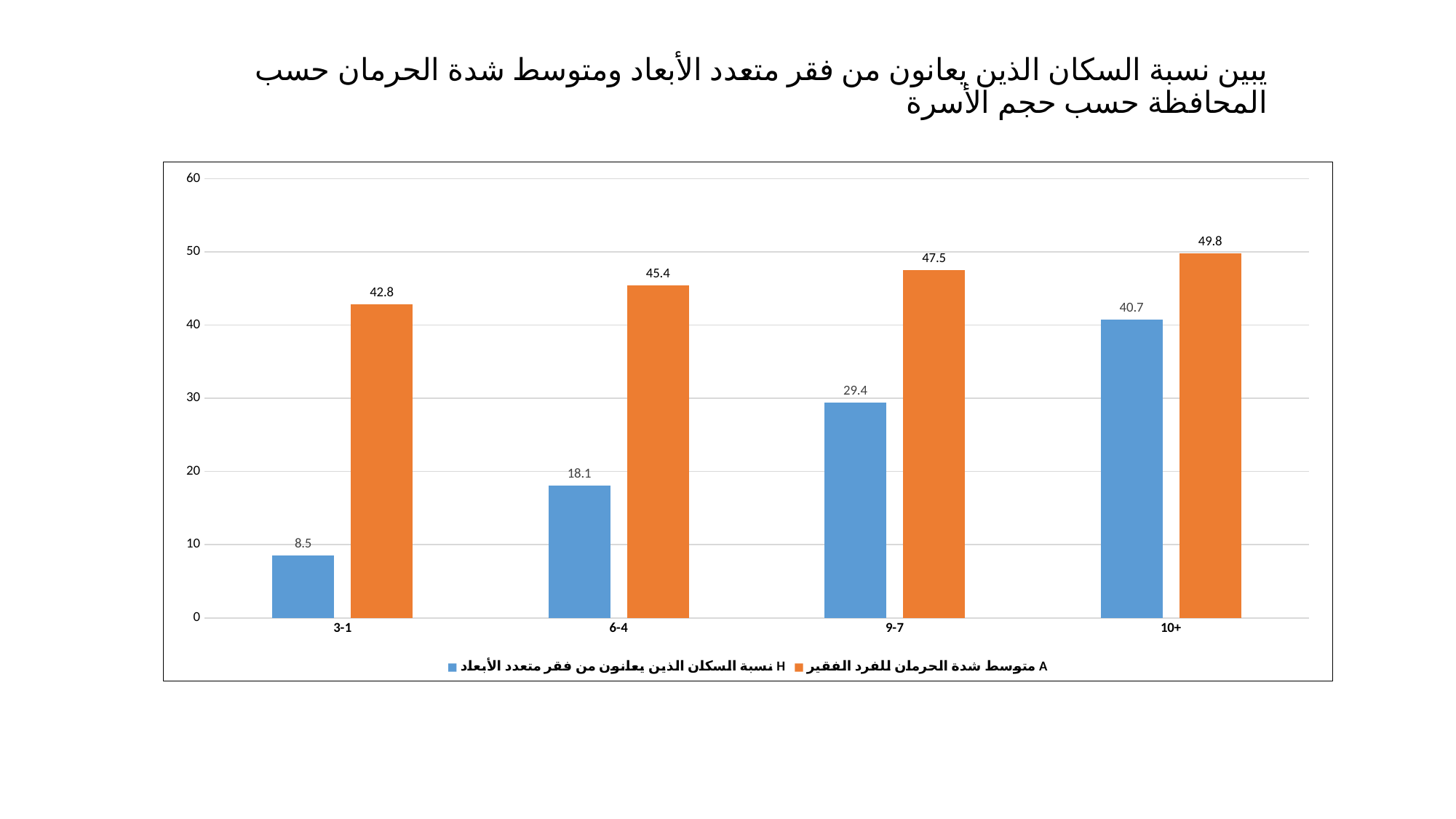
What is the value of the H series for household size 9-7? 29.4 How many series does the legend list? 2 What is the value of the A series (متوسط شدة الحرمان للفرد الفقير) for household size 10+? 49.8 What is the difference between the A series and the H series values for household size 3-1? 34.3 What kind of chart is shown on the slide? Bar chart Do the values of the H series rise or fall as household size increases from 3-1 to 10+? Rise What is the value of the A series for household size 6-4? 45.4 What is the value of the H series (نسبة السكان الذين يعانون من فقر متعدد الأبعاد) for household size 3-1? 8.5 Which household size category has the highest value for the H series? 10+ Which household size category has the lowest value for the A series? 3-1 For household size 10+, which series has the larger value, H or A? A How many household size categories are shown on the x axis? 4